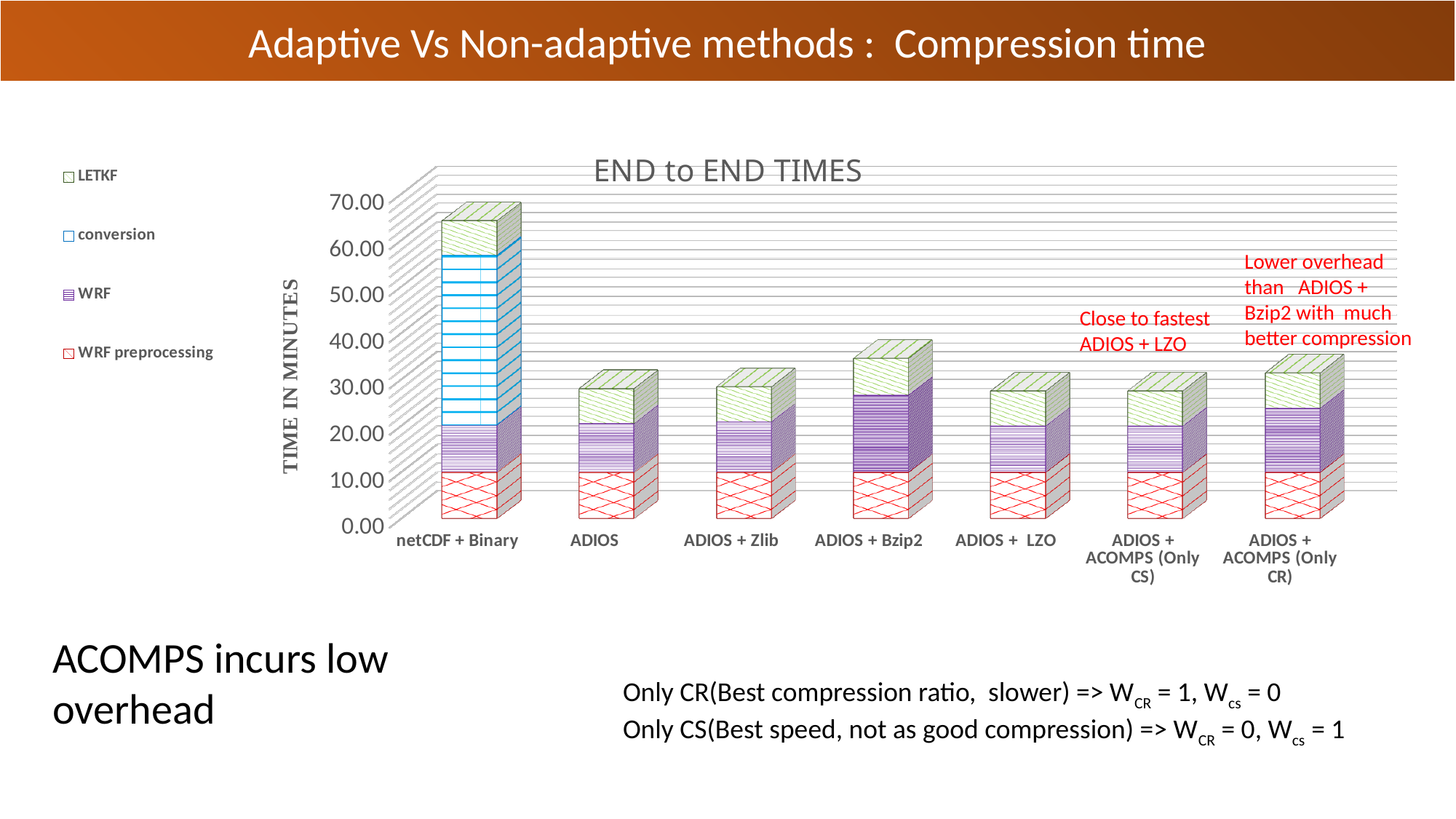
Is the total time for ADIOS + Bzip2 greater or less than 50.00 minutes? less What is the label of the vertical axis of the chart? TIME IN MINUTES What type of chart is shown on the slide? Stacked bar chart Is the total time for netCDF + Binary greater or less than 50.00 minutes? greater Which has a larger total time, ADIOS + Bzip2 or ADIOS + LZO? ADIOS + Bzip2 Which has a larger total time, netCDF + Binary or ADIOS? netCDF + Binary What is the title of the chart? END to END TIMES How many series does the chart legend list? 4 How many categories are shown on the x axis of the chart? 7 Which category has the highest total end-to-end time? netCDF + Binary Is the total time for ADIOS + LZO greater or less than 40.00 minutes? less